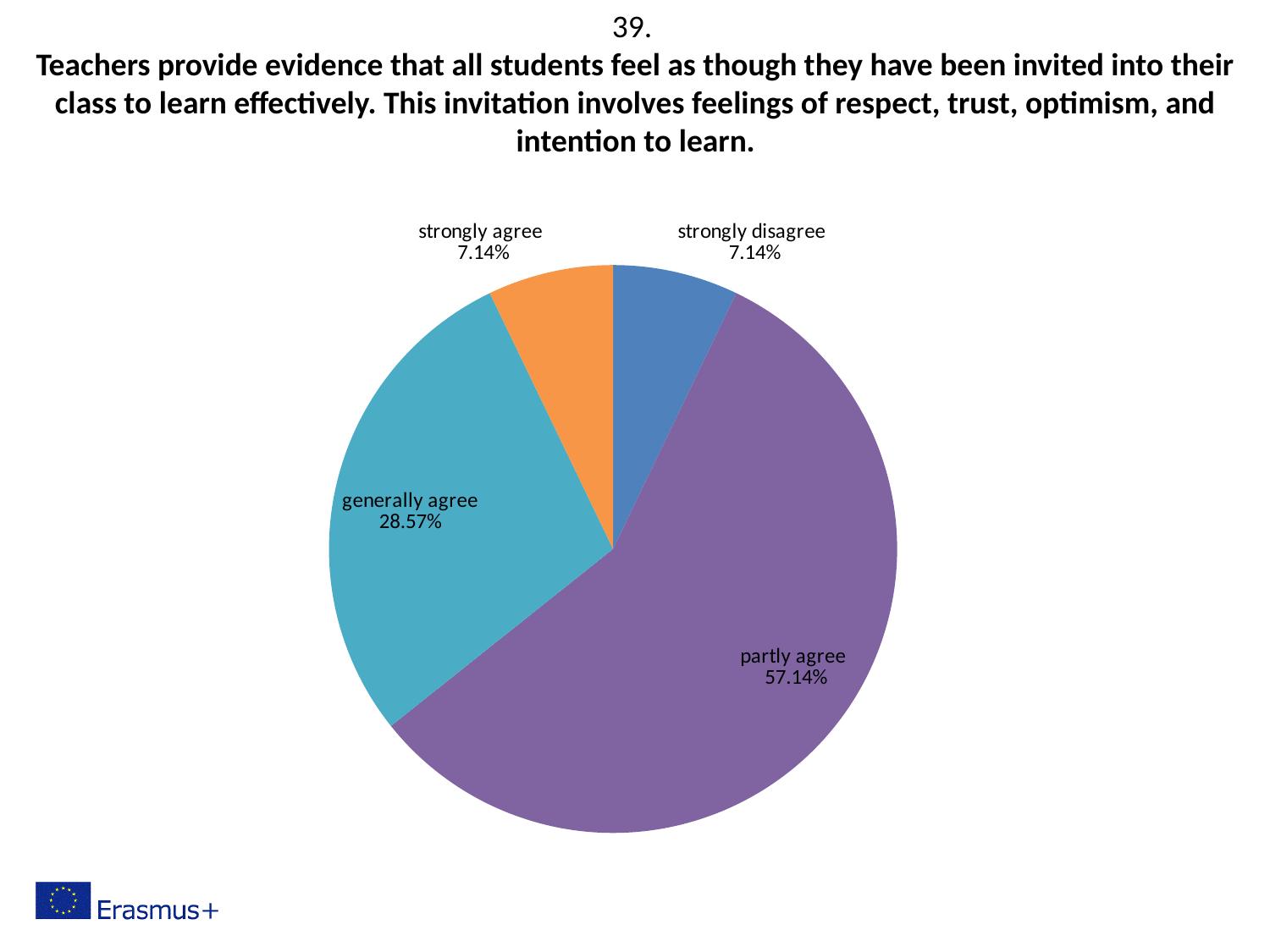
What kind of chart is shown on the slide? pie chart What is the difference in percentage points between "partly agree" and "generally agree"? 28.57 What is the combined share of "strongly agree" and "generally agree"? 35.71% Which two response categories have the same share? strongly agree and strongly disagree What percentage of respondents chose "strongly disagree"? 7.14% Which response category has the largest share of the pie? partly agree What percentage of respondents chose "generally agree"? 28.57% What colour is the "partly agree" slice? purple How many slices does the pie chart have? 4 Which is larger, the share for "generally agree" or the share for "strongly agree"? generally agree What percentage of respondents chose "partly agree"? 57.14% What percentage of respondents chose "strongly agree"? 7.14%